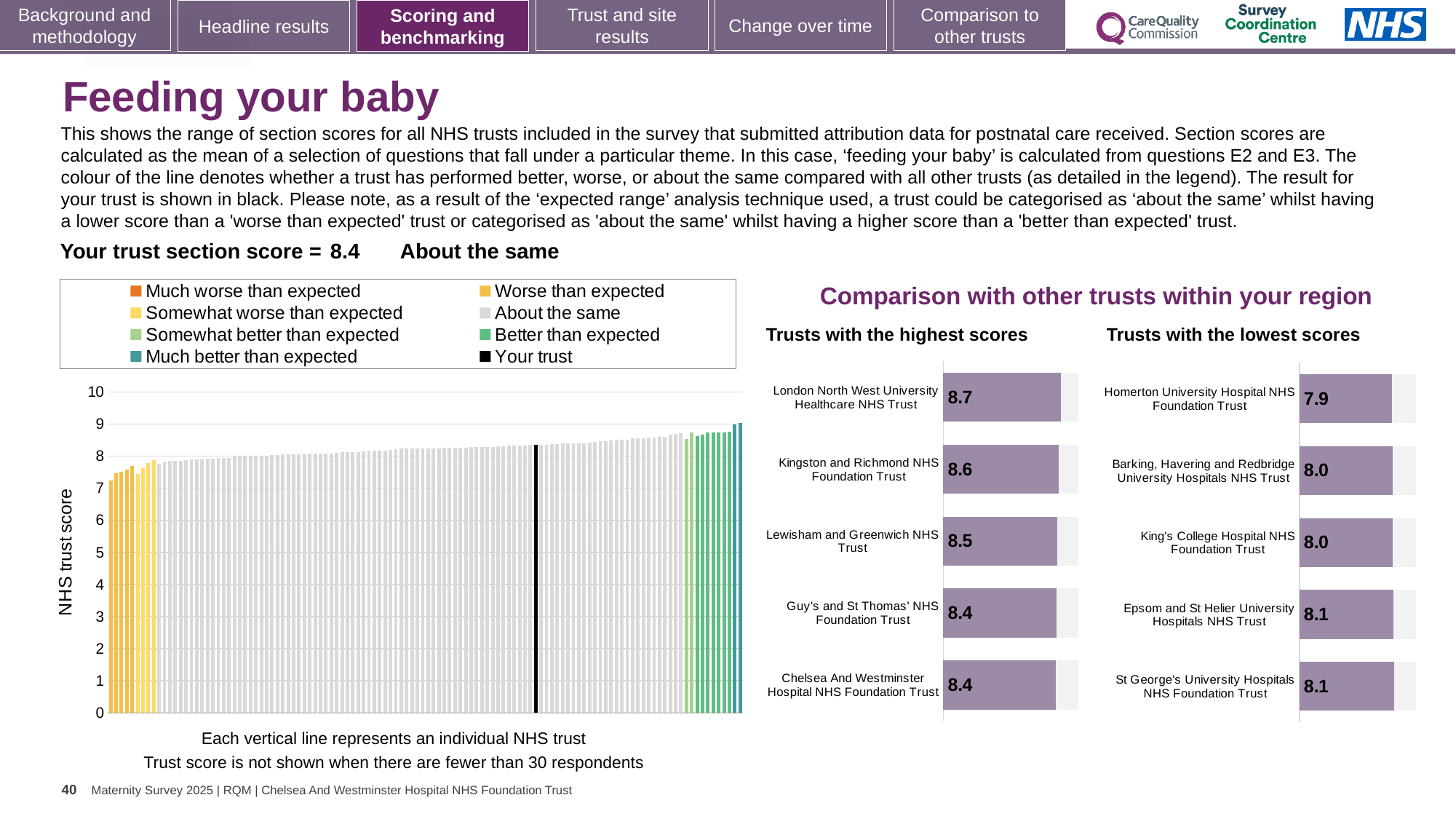
In the 'Trusts with the highest scores' chart, which trust has the highest score? London North West University Healthcare NHS Trust In the 'Trusts with the highest scores' chart, what is the score for London North West University Healthcare NHS Trust? 8.7 In the main 'NHS trust score' chart on the left, is the value of the black 'Your trust' bar greater or less than 8? greater In the 'Trusts with the highest scores' chart, what is the difference between the scores of London North West University Healthcare NHS Trust and Chelsea And Westminster Hospital NHS Foundation Trust? 0.3 In the 'Trusts with the lowest scores' chart, which trust has the lowest score? Homerton University Hospital NHS Foundation Trust In the 'Trusts with the lowest scores' chart, what is the score for Homerton University Hospital NHS Foundation Trust? 7.9 In the 'Trusts with the lowest scores' chart, which is larger: the score for Epsom and St Helier University Hospitals NHS Trust or the score for Homerton University Hospital NHS Foundation Trust? Epsom and St Helier University Hospitals NHS Trust In the main 'NHS trust score' chart on the left, how many entries does the legend list? 8 In the 'Trusts with the lowest scores' chart, what is the score for Kingston and Richmond NHS Foundation Trust's counterpart, Barking, Havering and Redbridge University Hospitals NHS Trust? 8.0 What kind of chart is the main 'NHS trust score' chart on the left? Bar chart In the main 'NHS trust score' chart on the left, do the bar values rise or fall from left to right? Rise In the 'Trusts with the highest scores' chart, how many trusts are listed? 5